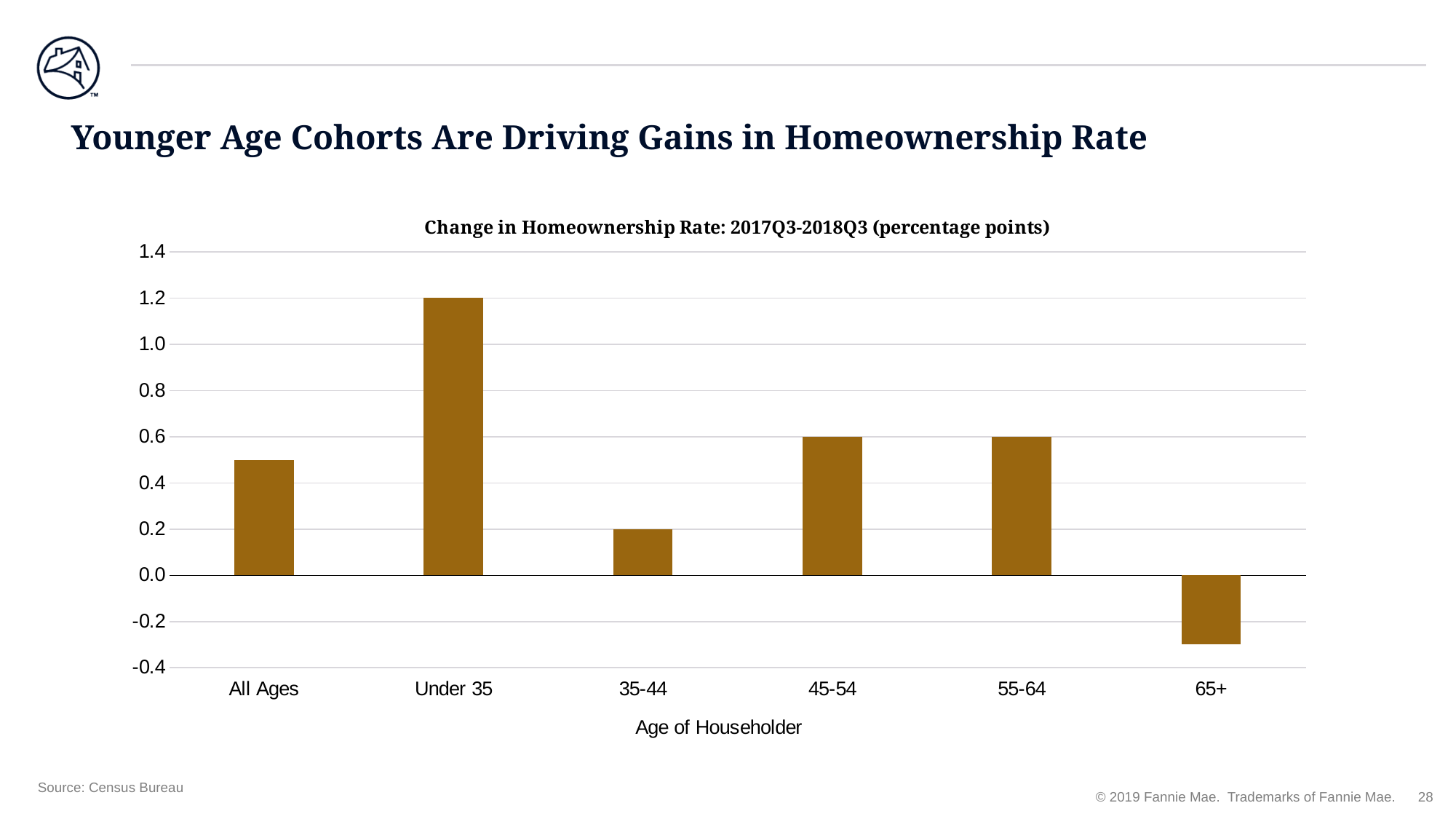
What is the change in homeownership rate for the Under 35 category? 1.2 What is the difference between the values for Under 35 and 35-44? 1.0 What is the change in homeownership rate for the 35-44 category? 0.2 What is the change in homeownership rate for the 45-54 category? 0.6 What is the title of the chart? Change in Homeownership Rate: 2017Q3-2018Q3 (percentage points) Is the value for All Ages greater or less than 0.4? greater How many age categories are plotted on the x axis? 6 What kind of chart is shown on the slide? Bar chart Which age category has the highest change in homeownership rate? Under 35 Which age category has the lowest change in homeownership rate? 65+ Which is larger, the value for Under 35 or the value for 55-64? Under 35 Is the value for 65+ greater or less than 0.0? less